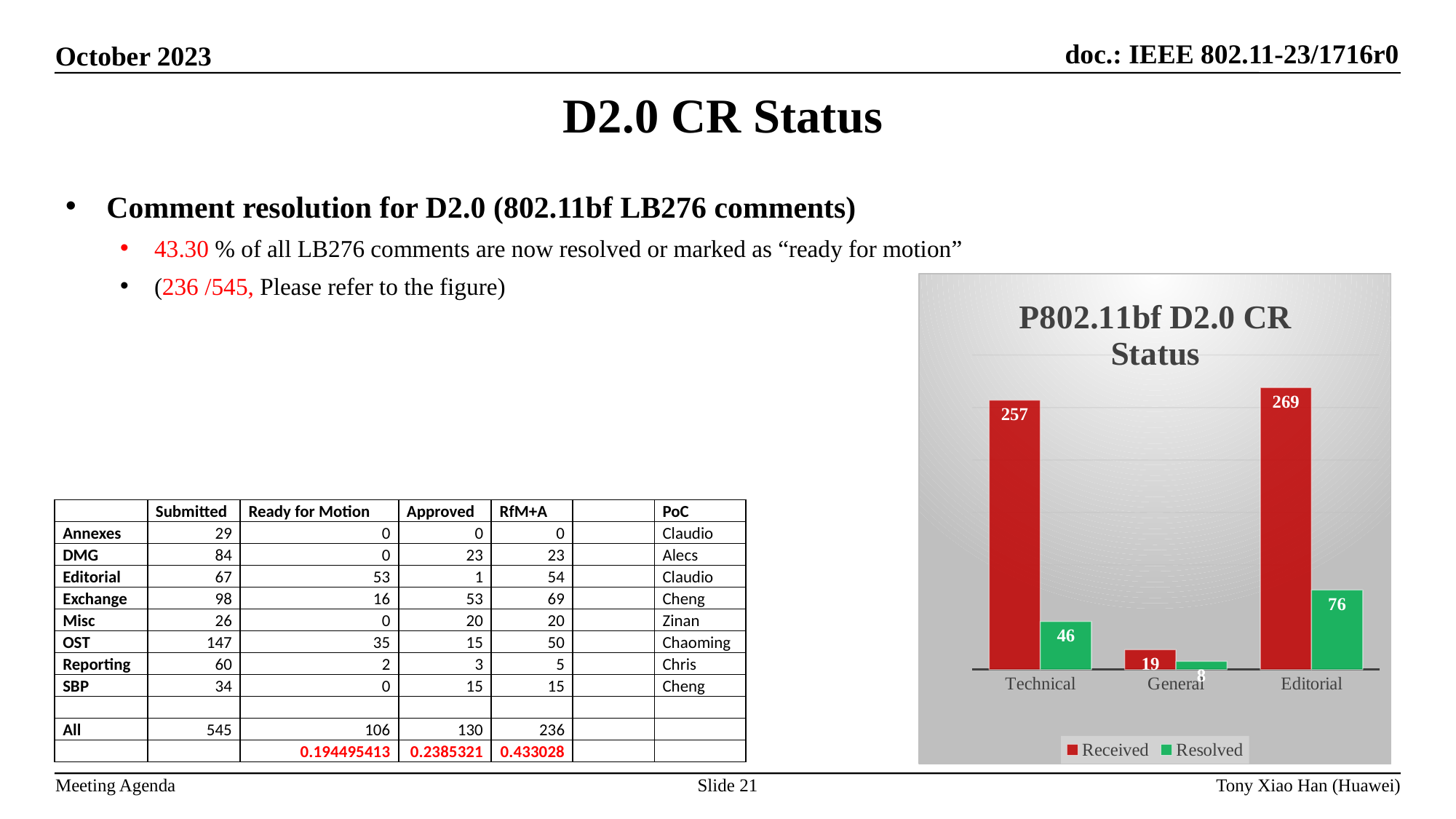
What is the difference between the Received values for Editorial and Technical? 12 How many series does the chart legend list? 2 What is the Received value for Technical? 257 Which is larger, the Resolved value for Editorial or the Resolved value for Technical? Editorial What type of chart is shown on the slide? bar chart What is the Resolved value for Technical? 46 How many categories are shown on the x axis of the chart? 3 What is the title of the chart? P802.11bf D2.0 CR Status Which category has the lowest Received value? General What is the Resolved value for Editorial? 76 What is the Received value for General? 19 Which category has the highest Received value? Editorial